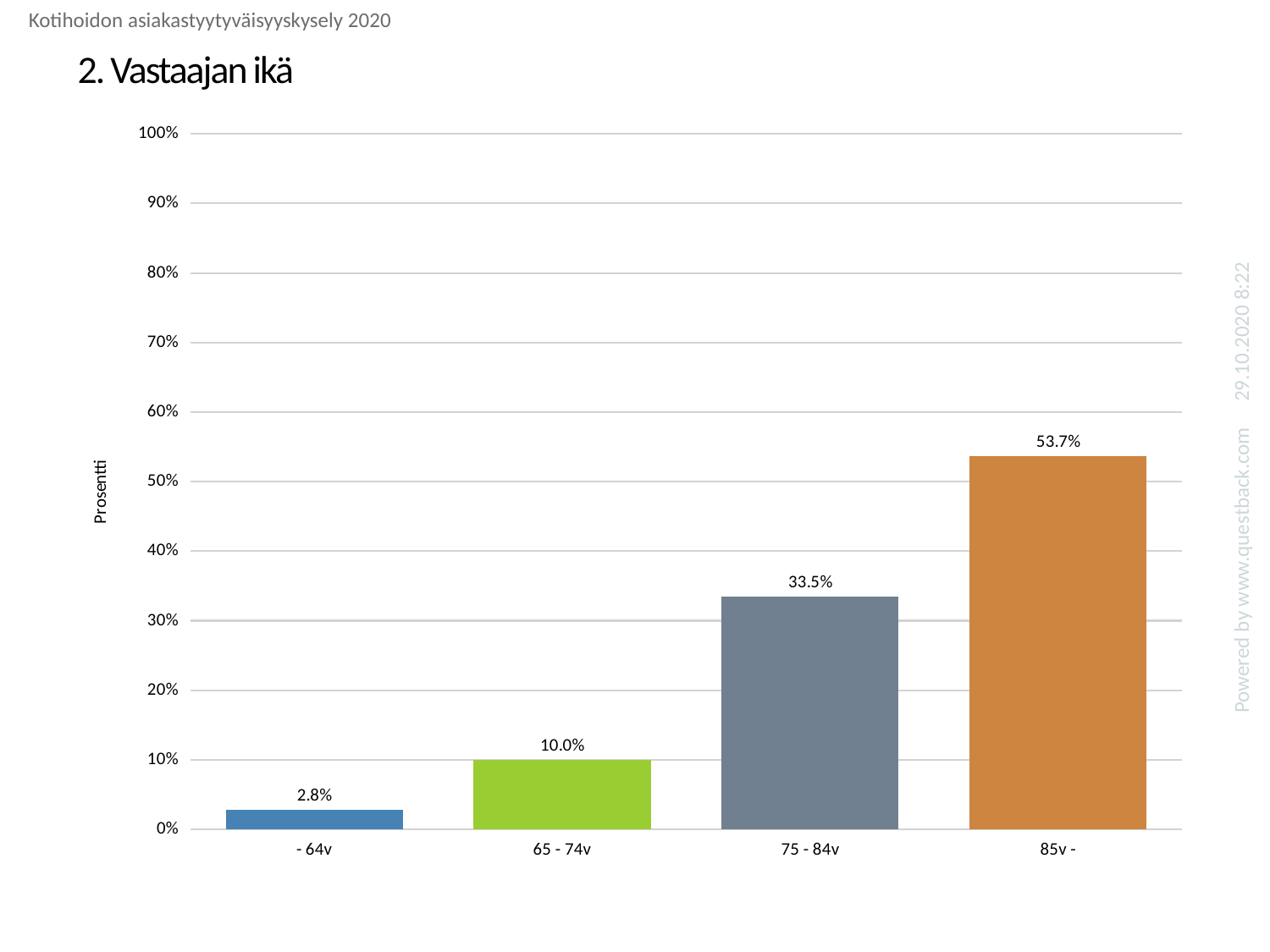
What is the difference between the values for 85v - and 75 - 84v? 20.2% What kind of chart is shown on the slide? bar chart How many age categories are shown on the x axis? 4 Which age category has the highest value? 85v - Do the values rise or fall from left to right along the x axis? rise What is the value for the - 64v category? 2.8% Which age category has the lowest value? - 64v What is the label of the y axis? Prosentti Is the value for 75 - 84v greater or less than 40%? less Which is larger, the value for 65 - 74v or the value for 75 - 84v? 75 - 84v What is the value for the 85v - category? 53.7% What is the value for the 65 - 74v category? 10.0%